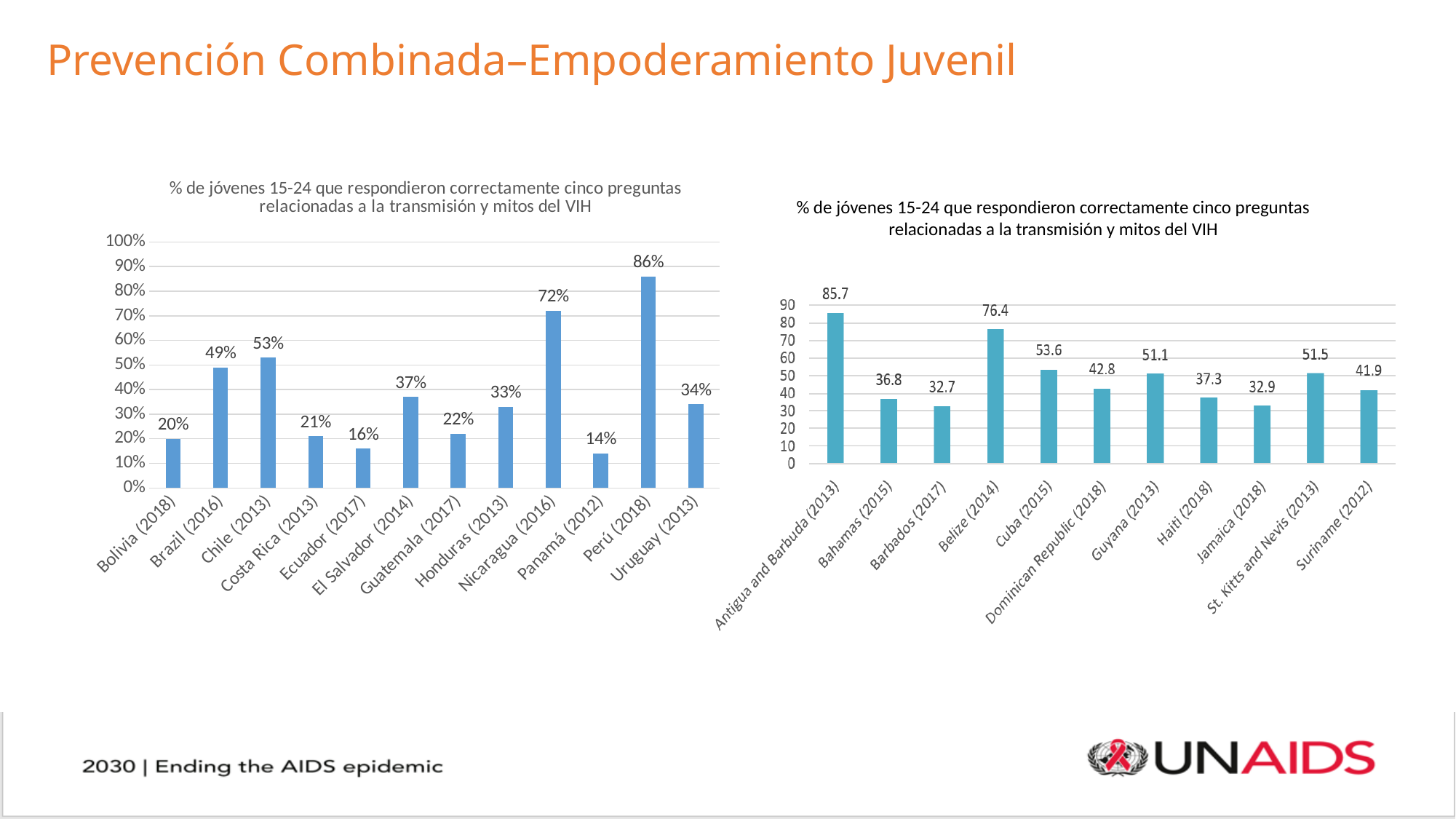
What type of chart is the right chart? Bar chart In the left chart, which is larger, Brazil (2016) or Chile (2013)? Chile (2013) In the right chart, what is the difference between Cuba (2015) and Dominican Republic (2018)? 10.8 In the left chart, what is the value for El Salvador (2014)? 37% In the right chart, what is the value for Belize (2014)? 76.4 In the left chart, which country has the lowest value? Panamá (2012) In the right chart, which country has the highest value? Antigua and Barbuda (2013) In the right chart, which country has the lowest value? Barbados (2017) In the left chart, what is the value for Perú (2018)? 86% In the left chart, what is the difference between Nicaragua (2016) and Honduras (2013)? 39% How many countries are shown in the right chart? 11 How many countries are shown in the left chart? 12